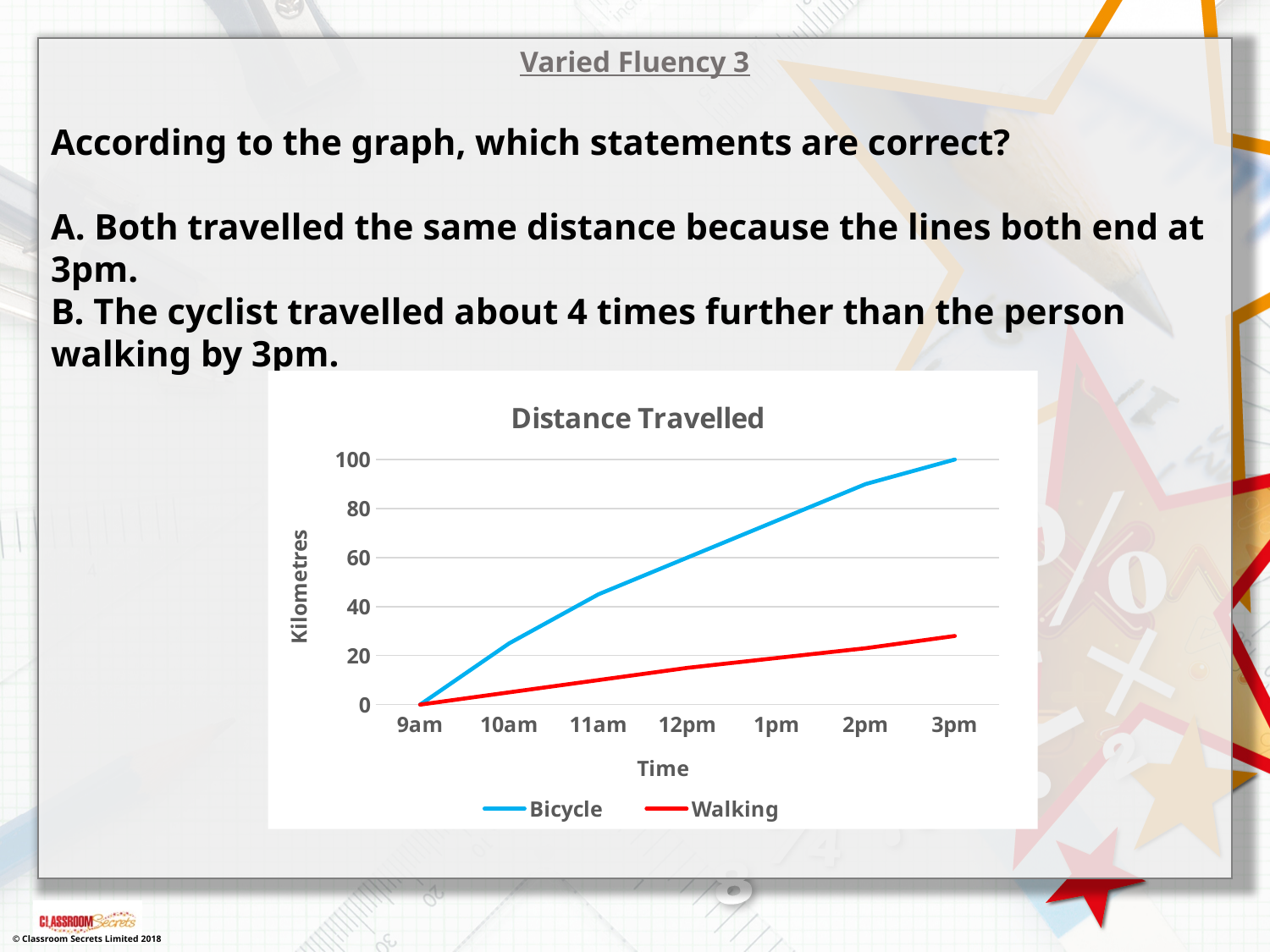
Which series has the larger value at 3pm, Bicycle or Walking? Bicycle What type of chart is shown on the slide? line chart What is the Walking value at 9am? 0 What is the Bicycle value at 3pm? 100 How many time points are shown on the x axis? 7 What is the label on the y axis? Kilometres Do the Bicycle values rise or fall from 9am to 3pm? rise Is the Bicycle value at 2pm greater or less than 80? greater How many series does the legend list? 2 What is the title of the chart? Distance Travelled Is the Walking value at 12pm greater or less than 20? less Is the Walking value at 3pm greater or less than 40? less